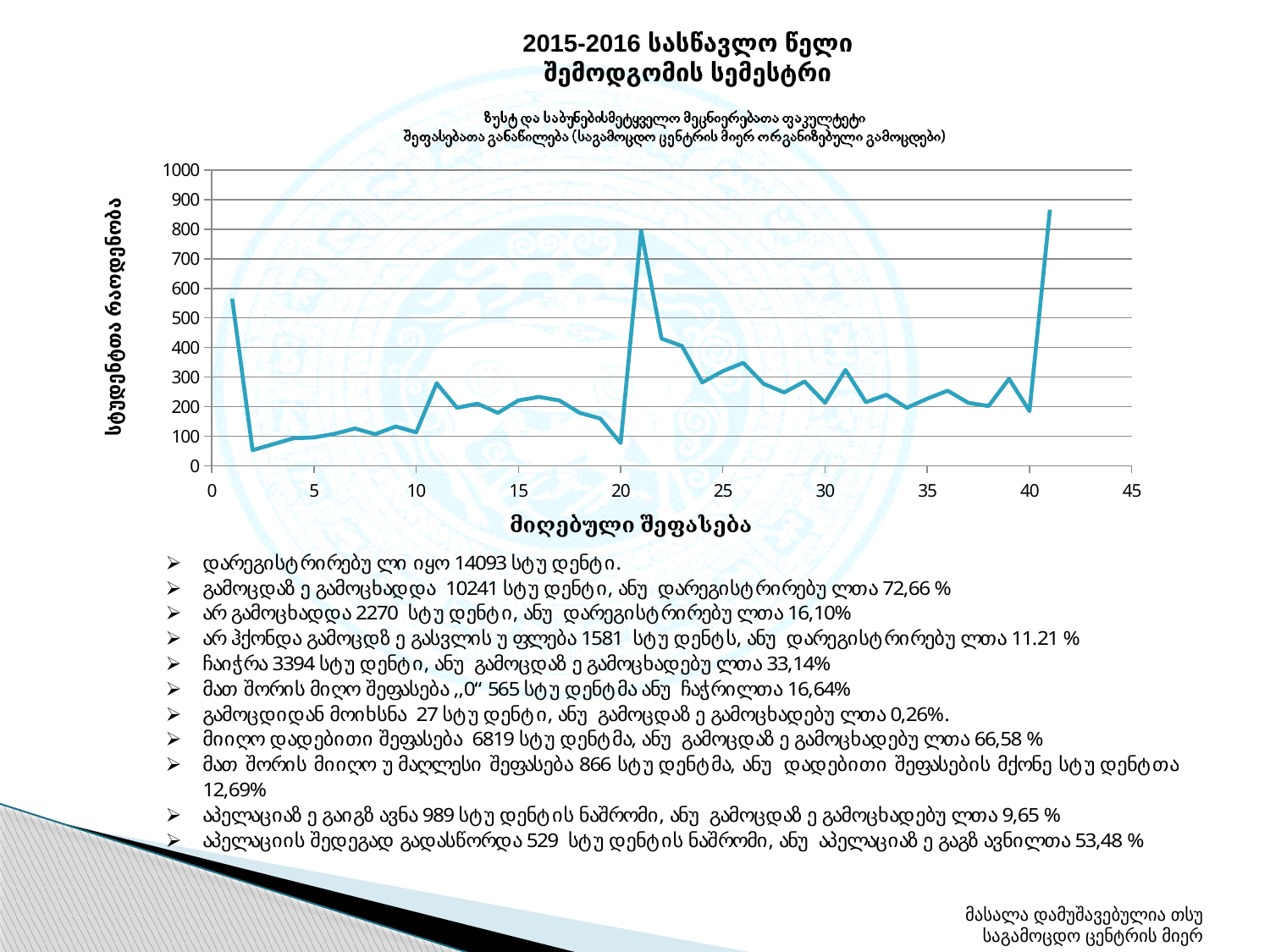
What is the title of the vertical axis of the chart? სტუდენტთა რაოდენობა What kind of chart is shown on the slide? line chart Do the values rise or fall from x = 21 to x = 24? fall Is the value at x = 2 greater or less than 100? less Which has the larger value, x = 21 or x = 1? x = 21 What is the title of the horizontal axis of the chart? მიღებული შეფასება Is the value at x = 21 greater or less than 700? greater Is the value at x = 20 greater or less than 100? less Which has the larger value, x = 11 or x = 5? x = 11